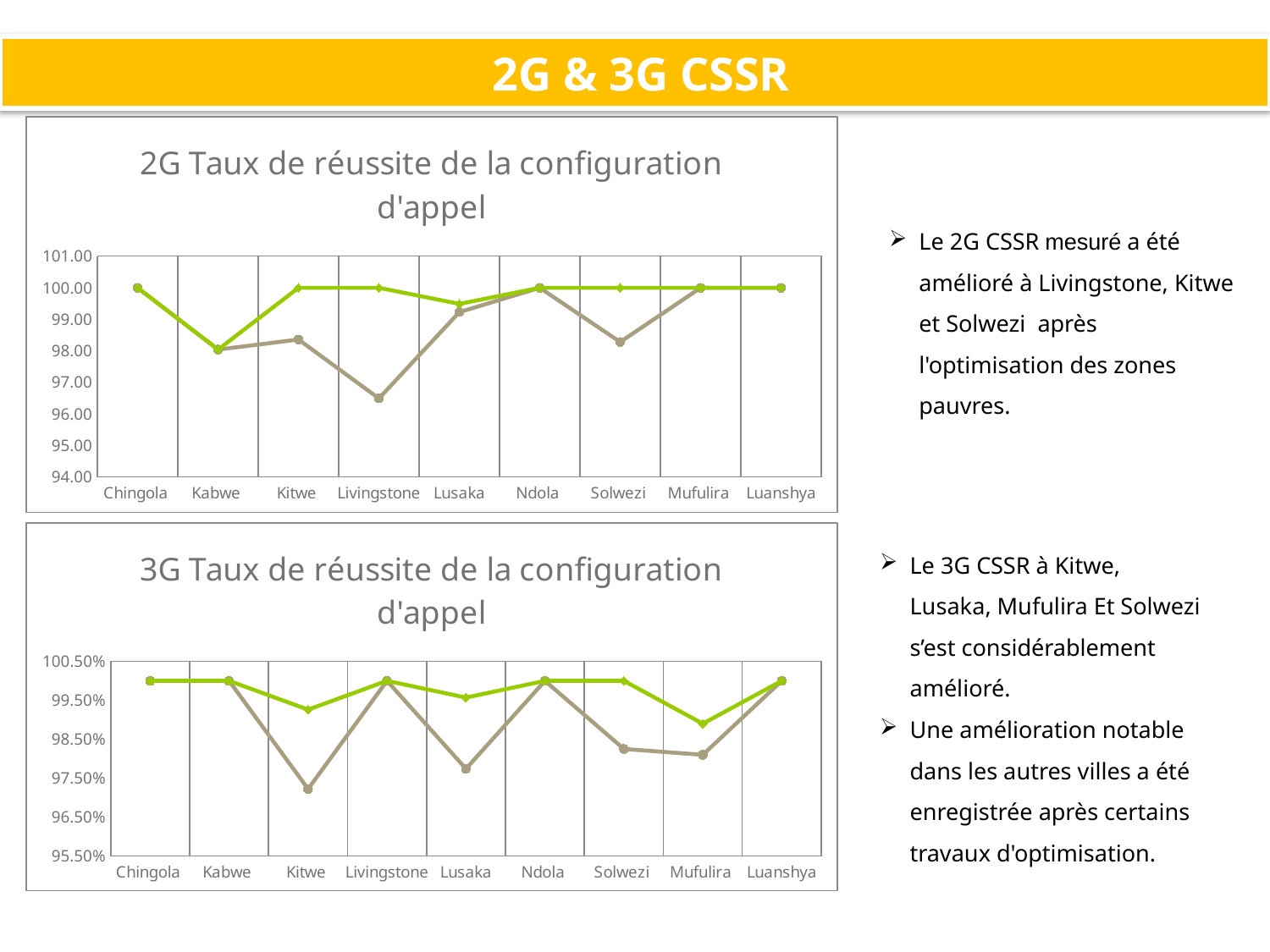
In the '2G Taux de réussite de la configuration d'appel' chart, is the grey line's value for Livingstone greater or less than 97.00? less In the '3G Taux de réussite de la configuration d'appel' chart, is the grey line's value for Kitwe greater or less than 97.50%? less In the '2G Taux de réussite de la configuration d'appel' chart, at which city does the grey line reach its lowest value? Livingstone What is the title of the top chart on the slide? 2G Taux de réussite de la configuration d'appel In the '3G Taux de réussite de la configuration d'appel' chart, is the green line's value for Mufulira greater or less than 98.50%? greater In the '2G Taux de réussite de la configuration d'appel' chart, at Livingstone, which line has the higher value, the green line or the grey line? the green line In the '3G Taux de réussite de la configuration d'appel' chart, at which city does the grey line reach its lowest value? Kitwe In the '2G Taux de réussite de la configuration d'appel' chart, what is the value of the green line at Chingola? 100.00 How many cities are shown on the x axis of the '2G Taux de réussite de la configuration d'appel' chart? 9 How many cities are shown on the x axis of the '3G Taux de réussite de la configuration d'appel' chart? 9 What kind of chart is the '2G Taux de réussite de la configuration d'appel' chart? line chart